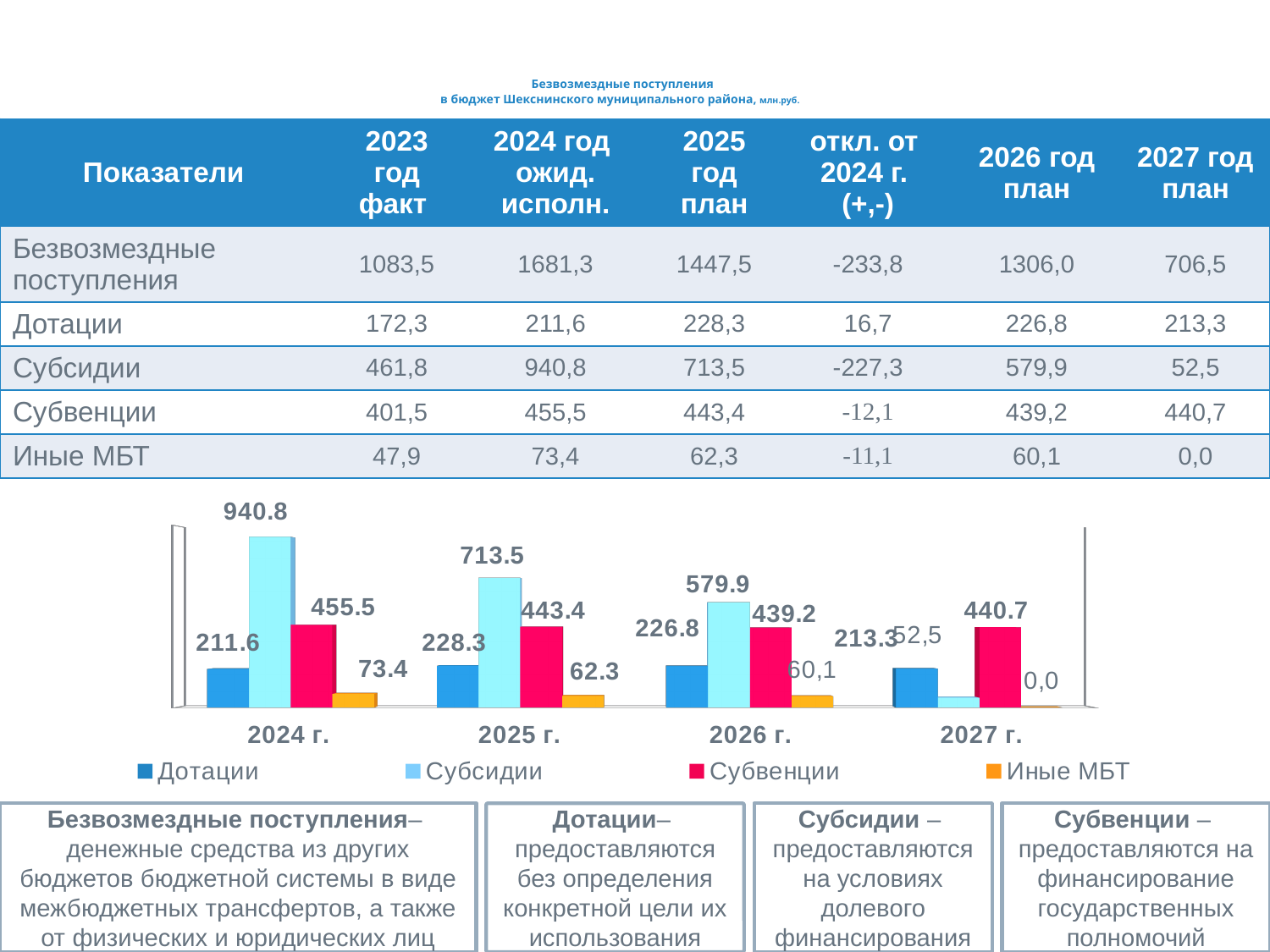
In the chart, what is the value of Субвенции for 2027 г.? 440.7 What kind of chart is shown on the slide? bar chart In the chart, do the values for Субсидии rise or fall from 2024 г. to 2027 г.? fall How many year categories are shown on the x axis of the chart? 4 In the chart, what is the difference between Субсидии in 2024 г. and Субсидии in 2025 г.? 227.3 How many series does the chart legend list? 4 In the chart, which year has the lowest value for Иные МБТ? 2027 г. In the chart, what is the value of Иные МБТ for 2025 г.? 62.3 In the chart, what is the value of Субсидии for 2024 г.? 940.8 In the chart, what is the value of Дотации for 2026 г.? 226.8 In the chart, which year has the highest value for Субсидии? 2024 г. In the chart, which is larger for 2026 г.: Субсидии or Субвенции? Субсидии